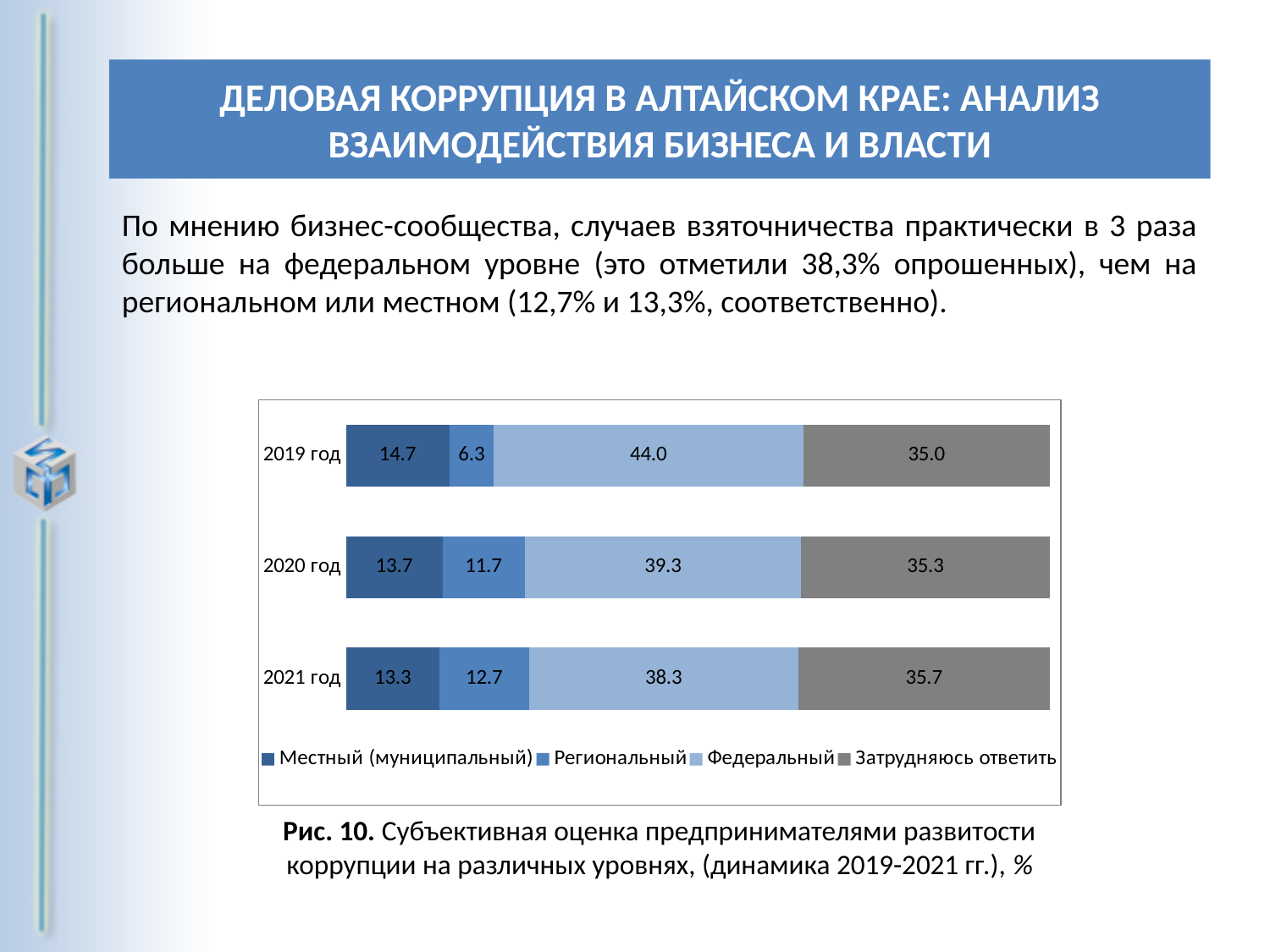
What kind of chart is shown on the slide? stacked bar chart In which year is the value for Федеральный the highest? 2019 год Which is larger: Местный (муниципальный) in 2019 год or Региональный in 2020 год? Местный (муниципальный) in 2019 год In which year is the value for Региональный the lowest? 2019 год What is the difference between the Федеральный values for 2019 год and 2021 год? 5.7 Does the value for Федеральный rise or fall from 2019 год to 2021 год? fall What is the value for Затрудняюсь ответить in 2021 год? 35.7 How many series does the legend list? 4 How many years (categories) are plotted on the chart? 3 What is the value for Федеральный in 2019 год? 44.0 What is the value for Региональный in 2021 год? 12.7 What is the value for Местный (муниципальный) in 2020 год? 13.7